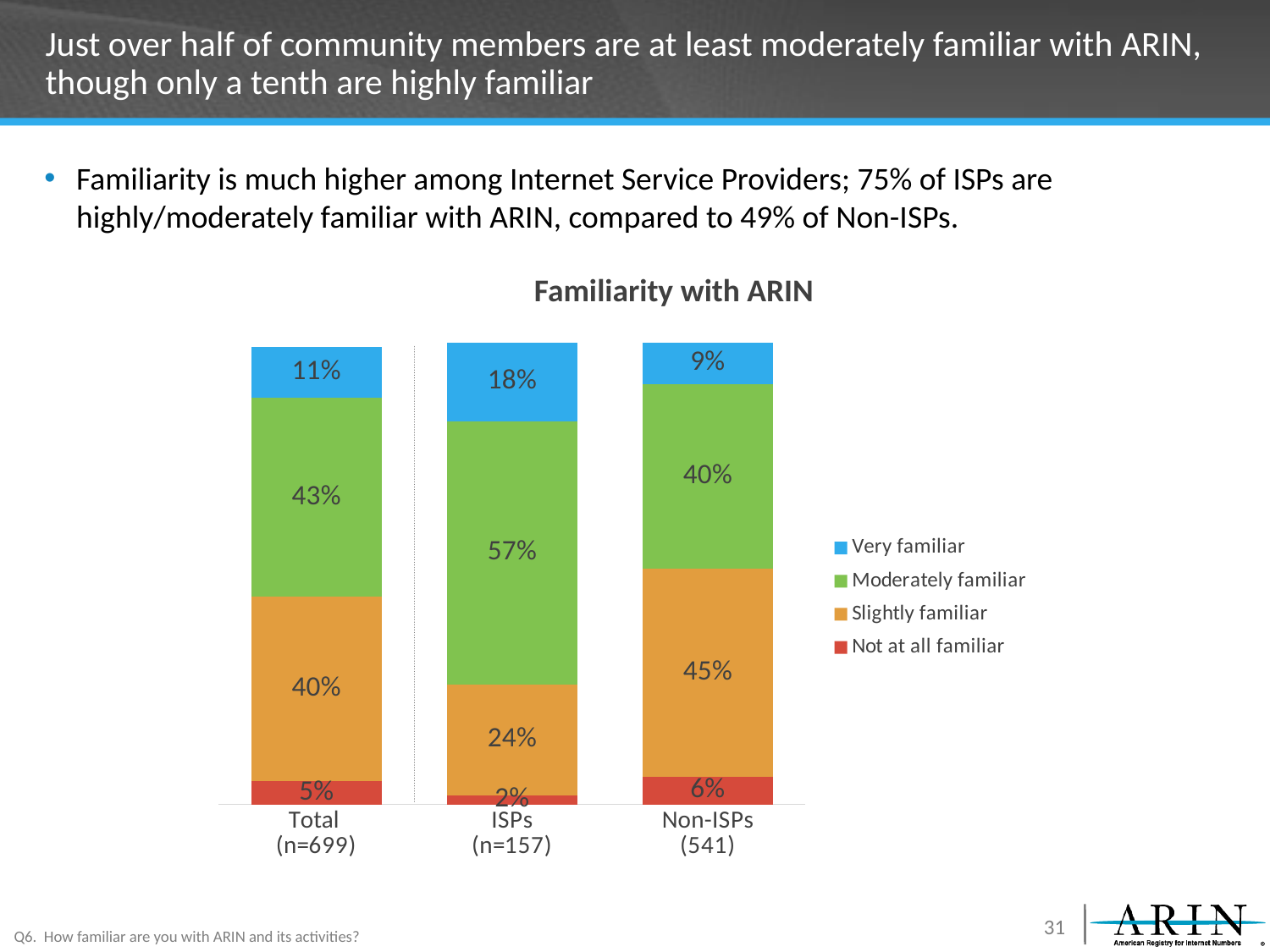
Which group has the highest share of respondents who are very familiar with ARIN? ISPs How many series does the legend list? 4 What percentage of Non-ISPs are slightly familiar with ARIN? 45% What is the combined share of very familiar and moderately familiar respondents among ISPs? 75% What percentage of ISPs are moderately familiar with ARIN? 57% Which group has the lowest share of respondents who are moderately familiar with ARIN? Non-ISPs What percentage of ISPs are not at all familiar with ARIN? 2% How many groups are shown on the x axis of the chart? 3 What is the difference between the moderately familiar share for ISPs and for Non-ISPs? 17 percentage points What percentage of the Total group is very familiar with ARIN? 11% Is the slightly familiar share larger for ISPs or for Non-ISPs? Non-ISPs What kind of chart is shown on the slide? Stacked bar chart